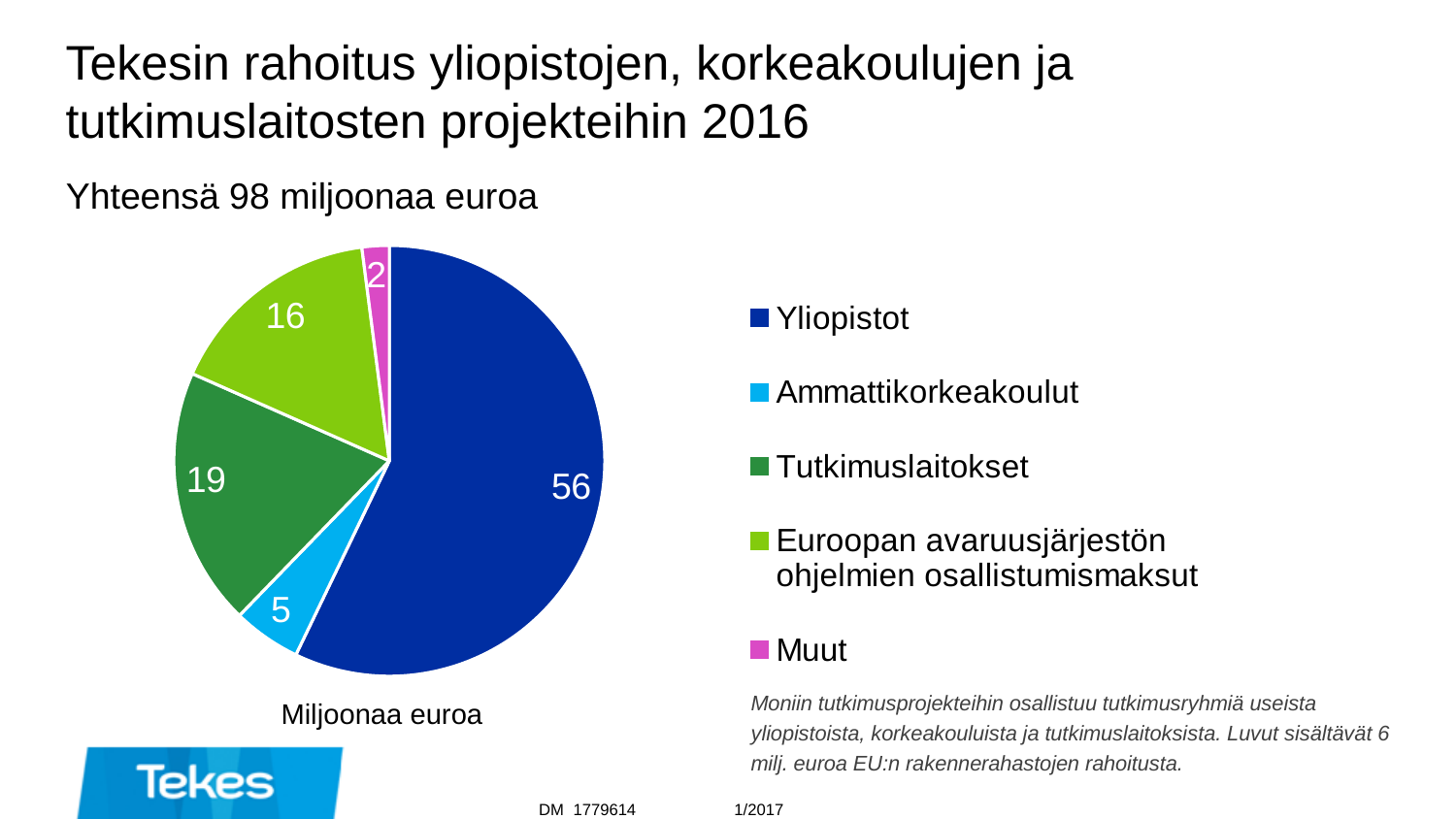
Which category has the smallest slice of the pie chart? Muut What kind of chart is shown on the slide? pie chart What is the difference between the values for Yliopistot and Tutkimuslaitokset? 37 What is the value for Tutkimuslaitokset in the pie chart? 19 Which is larger, the value for Tutkimuslaitokset or the value for Euroopan avaruusjärjestön ohjelmien osallistumismaksut? Tutkimuslaitokset What is the value for Euroopan avaruusjärjestön ohjelmien osallistumismaksut in the pie chart? 16 What is the value for Yliopistot in the pie chart? 56 What is the total of all slices in the pie chart, in millions of euros? 98 What is the value for Muut in the pie chart? 2 How many categories does the legend of the pie chart list? 5 What is the value for Ammattikorkeakoulut in the pie chart? 5 Which category has the largest slice of the pie chart? Yliopistot